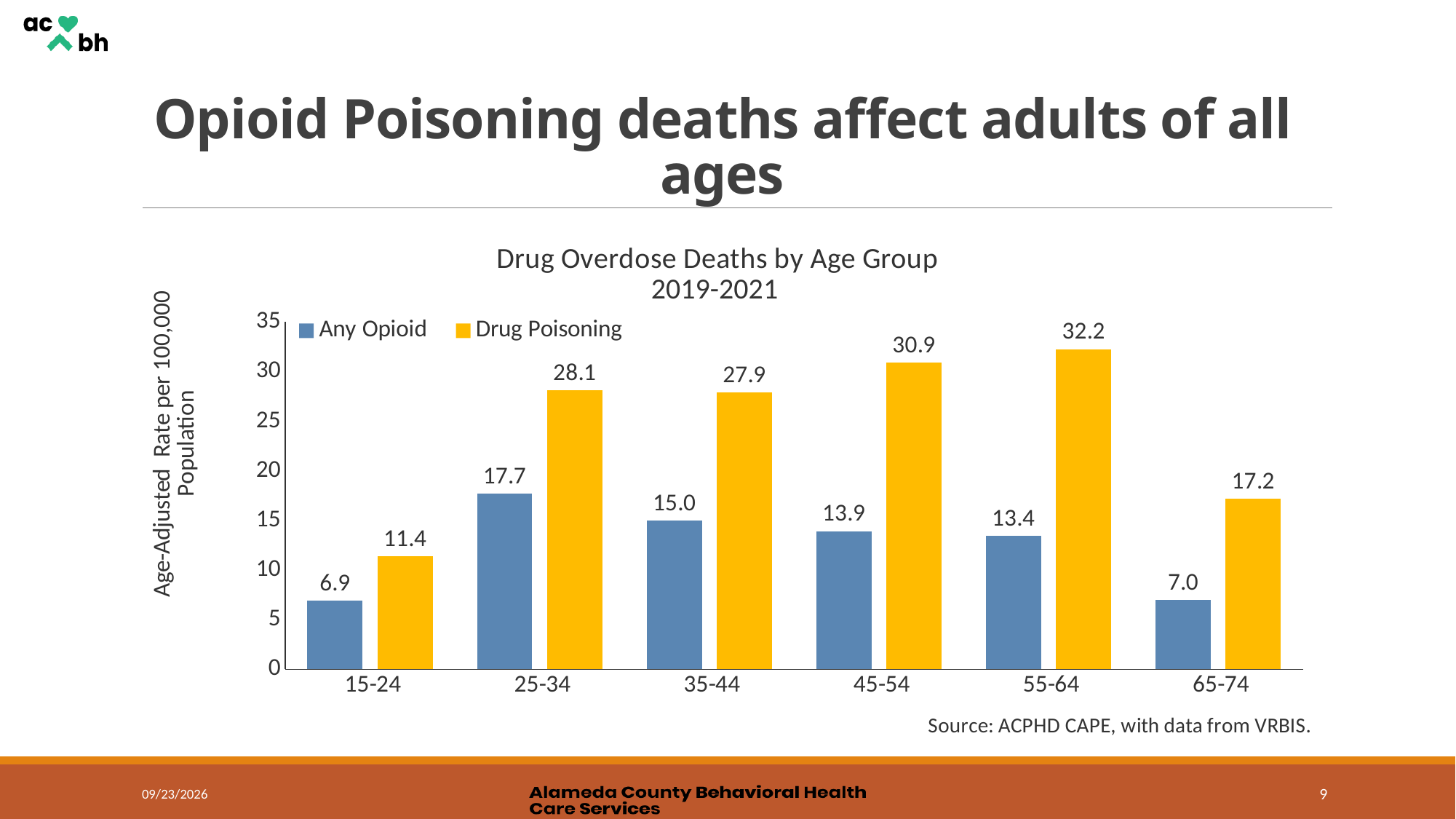
Is the Drug Poisoning rate for the 65-74 age group greater or less than 20? less What is the Any Opioid rate for the 25-34 age group? 17.7 What is the title of the chart? Drug Overdose Deaths by Age Group 2019-2021 What kind of chart is shown on the slide? Bar chart Which age group has the highest Drug Poisoning rate? 55-64 Which age group has the lowest Any Opioid rate? 15-24 What is the Drug Poisoning rate for the 55-64 age group? 32.2 What is the difference between the Drug Poisoning and Any Opioid rates for the 45-54 age group? 17.0 Which is larger, the Any Opioid rate for 35-44 or the Any Opioid rate for 55-64? 35-44 How many series does the legend list? 2 What is the Drug Poisoning rate for the 15-24 age group? 11.4 How many age groups are shown on the x axis? 6